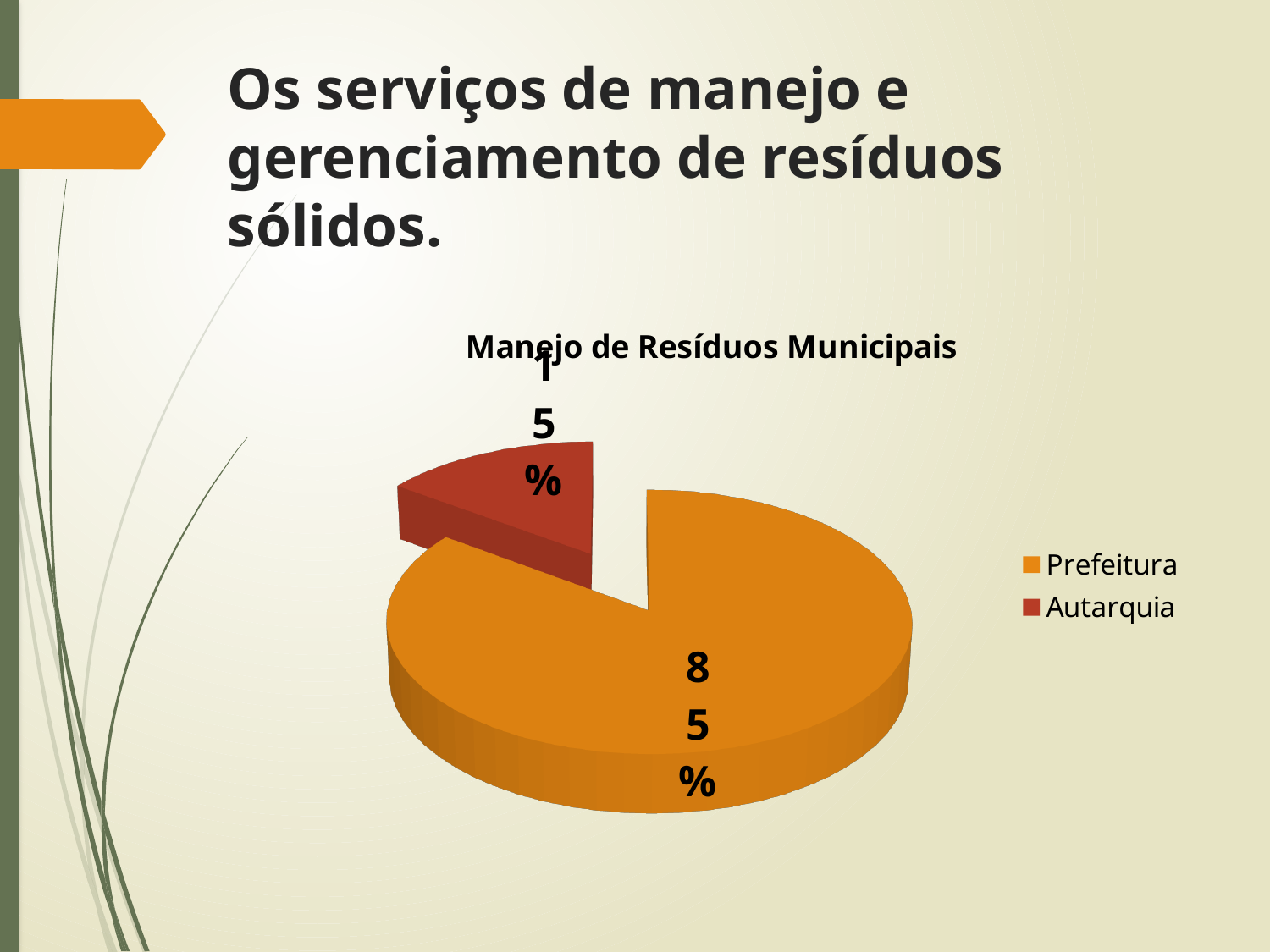
What is the difference in percentage points between the Prefeitura and Autarquia slices? 70 What kind of chart is shown on the slide? Pie chart Which category has the smallest slice of the pie? Autarquia Which is larger, the Prefeitura slice or the Autarquia slice? Prefeitura What share of the pie does Autarquia hold? 15% Which category has the largest slice of the pie? Prefeitura What share of the pie does Prefeitura hold? 85% Is the value for Prefeitura greater or less than 50%? greater What is the title of the chart? Manejo de Resíduos Municipais How many categories does the pie chart show? 2 What colour is the Autarquia slice? Red